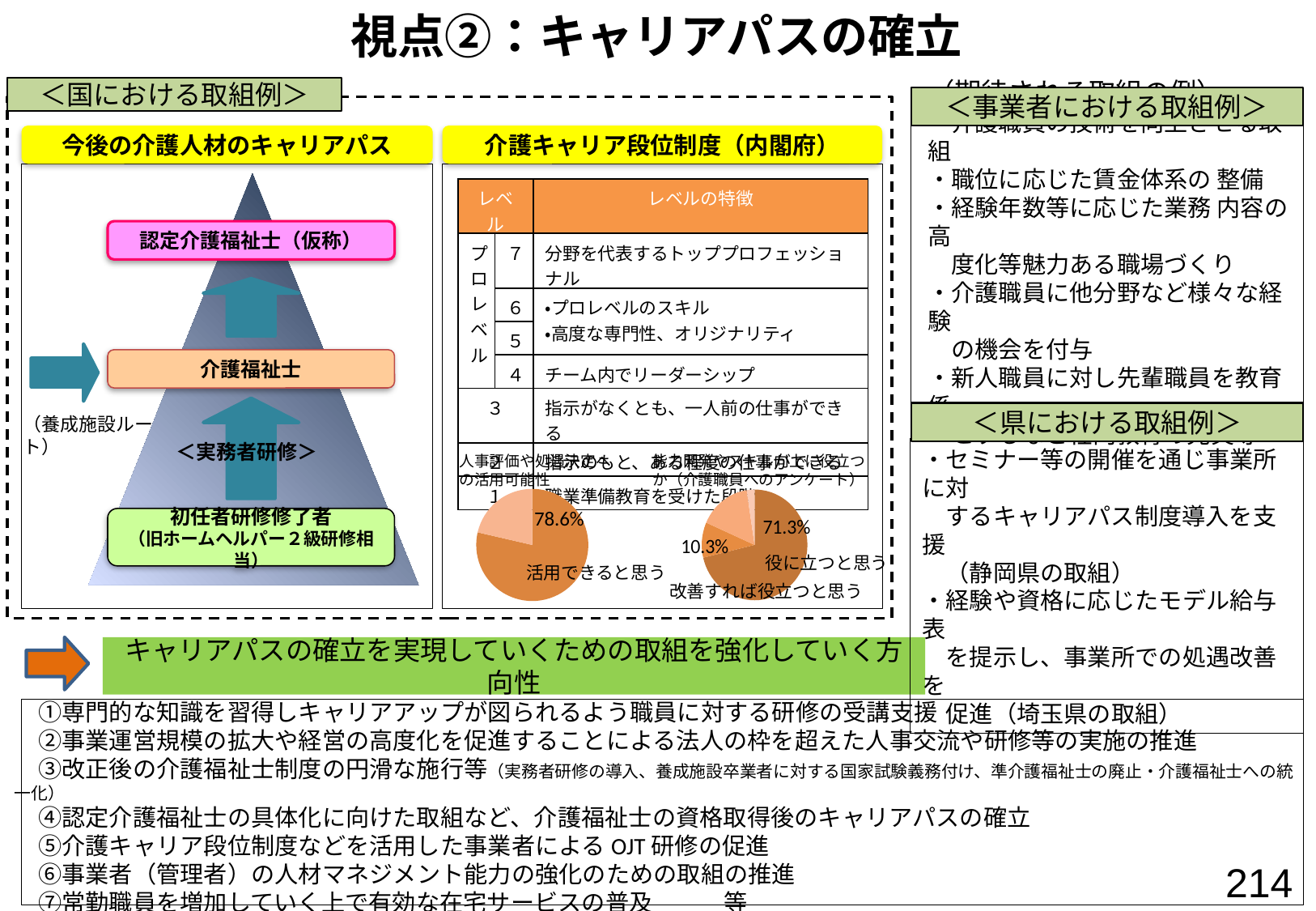
In the right pie chart, which slice is the largest? 役に立つと思う What colour is the largest slice in the left pie chart? orange What is the difference between the 活用できると思う share (78.6%) in the left pie chart and the 役に立つと思う share (71.3%) in the right pie chart? 7.3 percentage points What kind of chart is the left chart at the bottom of the middle panel (the one labelled 活用できると思う)? pie chart How many pie charts are shown on the slide? 2 In the left pie chart, what percentage is shown for 活用できると思う? 78.6% Which is larger: the 活用できると思う share in the left pie chart or the 役に立つと思う share in the right pie chart? 活用できると思う (left pie chart) In the right pie chart, is the share for 役に立つと思う greater or less than 50%? greater In the left pie chart, which slice is the largest? 活用できると思う In the right pie chart, what percentage is shown for 役に立つと思う? 71.3% What is the smaller percentage value printed on the right pie chart? 10.3%